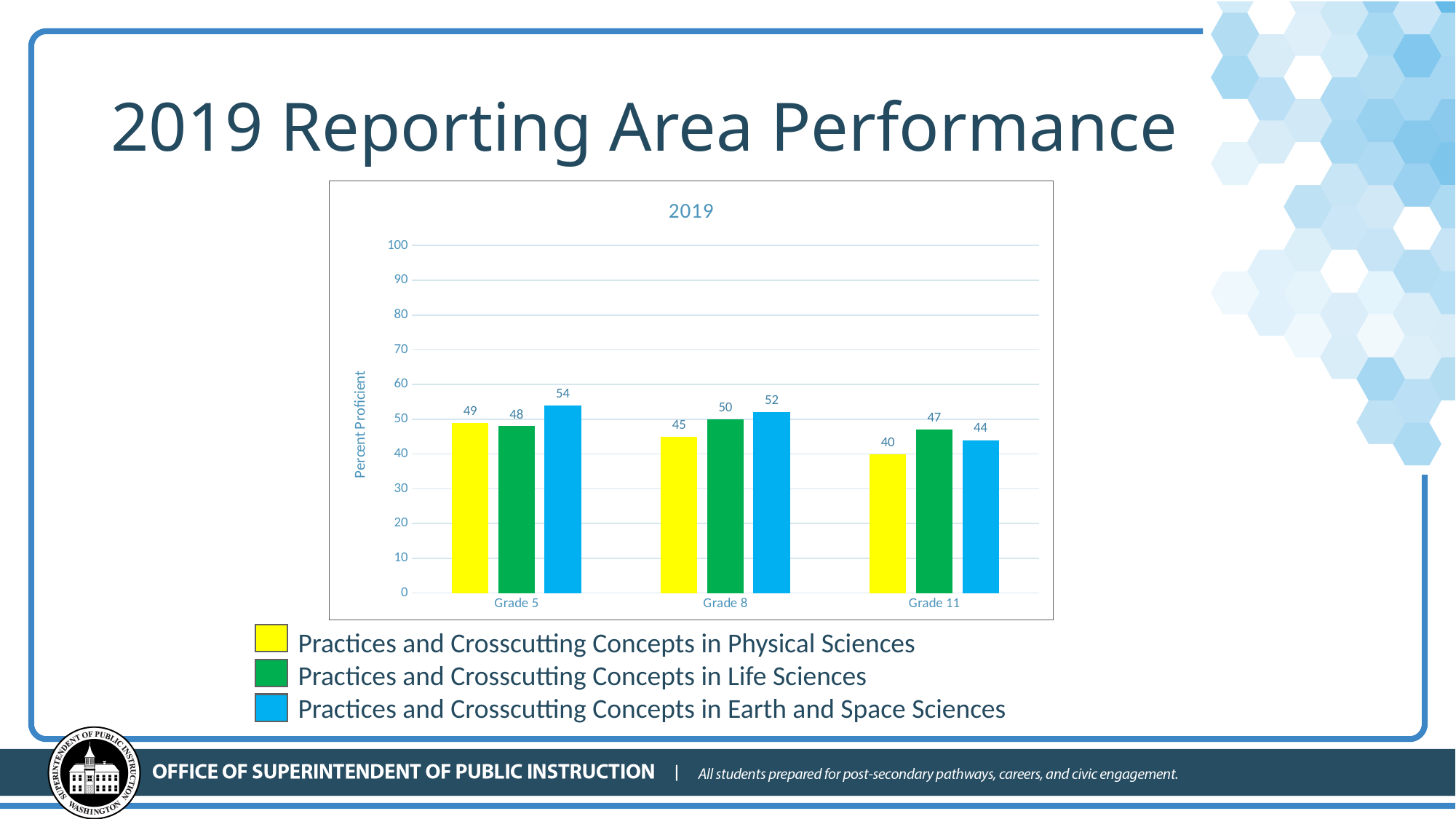
For Grade 11, which is larger: the Life Sciences value or the Earth and Space Sciences value? Life Sciences What is the value for Practices and Crosscutting Concepts in Life Sciences for Grade 8? 50 How many grade categories are shown on the x axis? 3 What is the label of the vertical axis? Percent Proficient How many series does the legend list? 3 Is the value for Practices and Crosscutting Concepts in Physical Sciences for Grade 8 greater or less than 50? less What is the value for Practices and Crosscutting Concepts in Earth and Space Sciences for Grade 5? 54 Which grade has the lowest value for Practices and Crosscutting Concepts in Earth and Space Sciences? Grade 11 Which grade has the highest value for Practices and Crosscutting Concepts in Physical Sciences? Grade 5 What is the difference between the Earth and Space Sciences value and the Physical Sciences value for Grade 8? 7 What is the value for Practices and Crosscutting Concepts in Physical Sciences for Grade 11? 40 What kind of chart is shown on the slide? bar chart